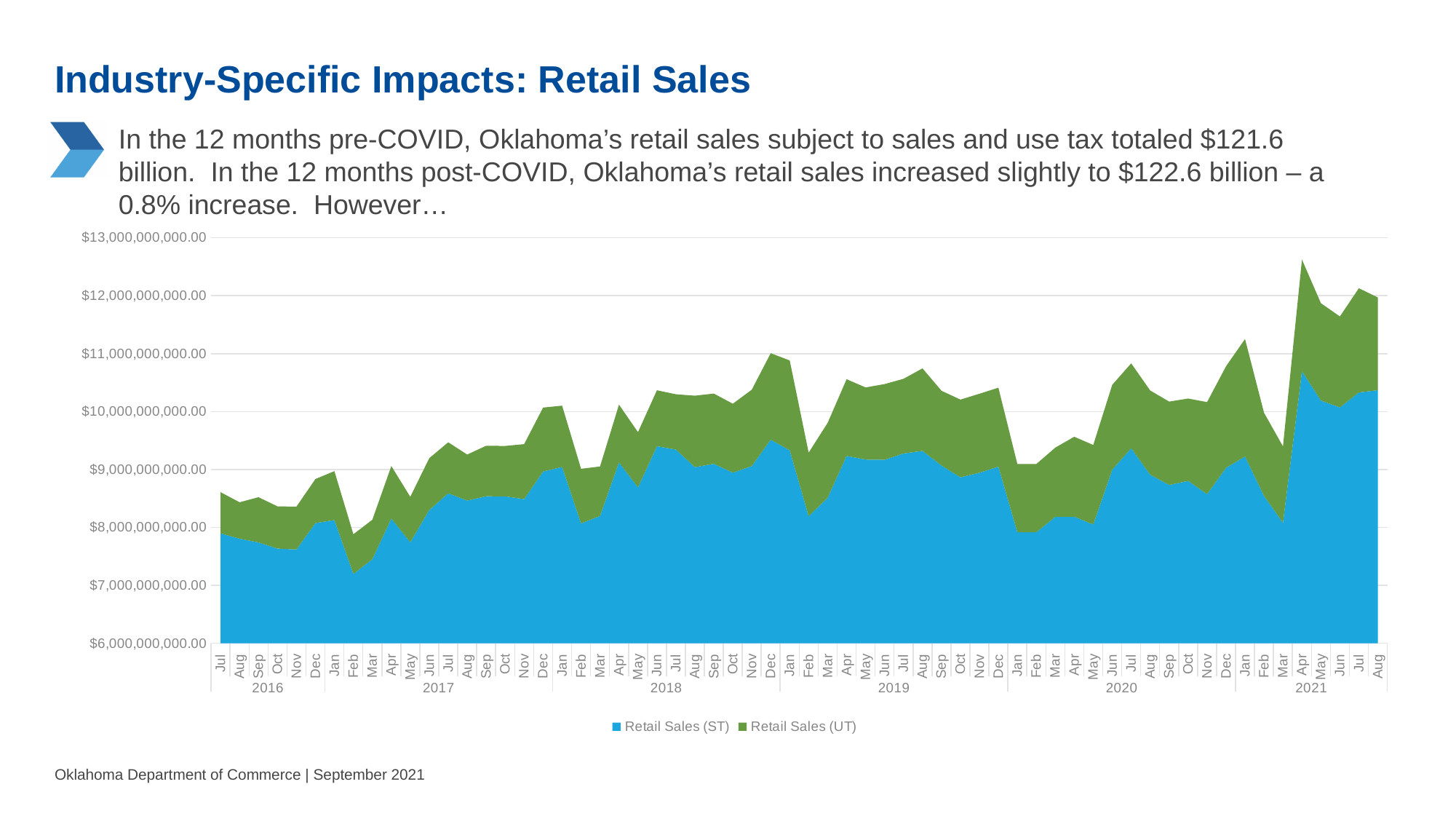
What are the two series named in the chart legend? Retail Sales (ST) and Retail Sales (UT) Overall, do combined retail sales rise or fall from Jul 2016 to Aug 2021? Rise How many series does the chart legend list? 2 In which month and year does the combined retail sales total reach its highest point? Apr 2021 Is the combined total of Retail Sales (ST) and Retail Sales (UT) in Apr 2021 greater or less than $12,000,000,000.00? greater Is the value for Retail Sales (ST) in Feb 2017 greater or less than $8,000,000,000.00? less What kind of chart is shown on the slide? Stacked area chart Is the value for Retail Sales (ST) in Apr 2021 greater or less than $10,000,000,000.00? greater Which colour represents Retail Sales (UT) in the chart? Green In which month and year is Retail Sales (ST) at its lowest? Feb 2017 How many years are labelled along the x axis of the chart? 6 Which is larger: Retail Sales (ST) in Apr 2021 or Retail Sales (ST) in Apr 2020? Apr 2021